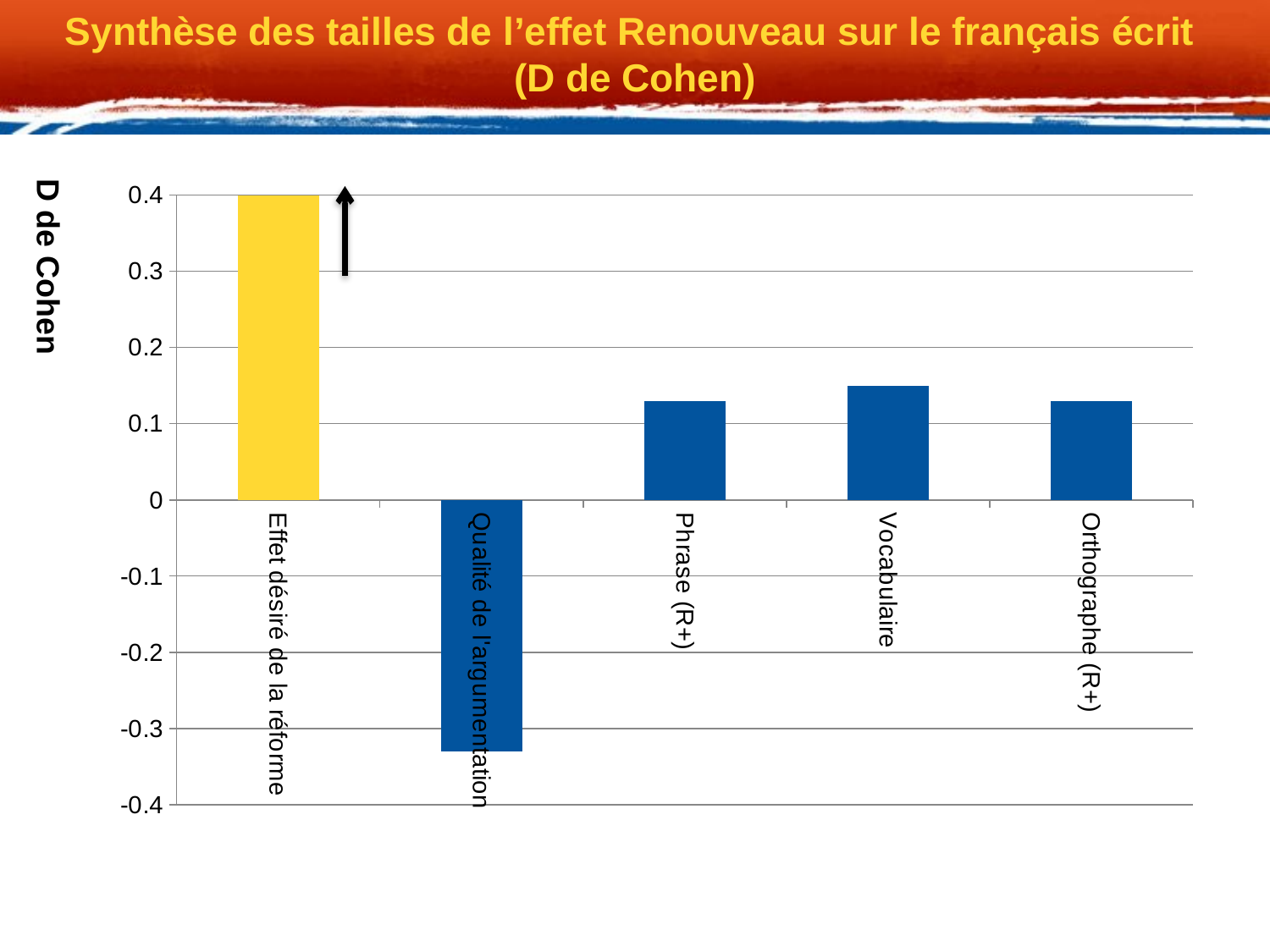
Is the value for Orthographe (R+) greater or less than 0.2? less Which category has the lowest value in the chart? Qualité de l'argumentation How many categories are plotted in the chart? 5 What is the label of the vertical axis? D de Cohen Which category has the highest value in the chart? Effet désiré de la réforme How many categories have a negative value? 1 What is the value for Effet désiré de la réforme? 0.4 What kind of chart is shown on the slide? bar chart Is the value for Vocabulaire greater or less than 0.2? less Which is larger, the value for Effet désiré de la réforme or the value for Vocabulaire? Effet désiré de la réforme Is the value for Phrase (R+) greater or less than 0.1? greater